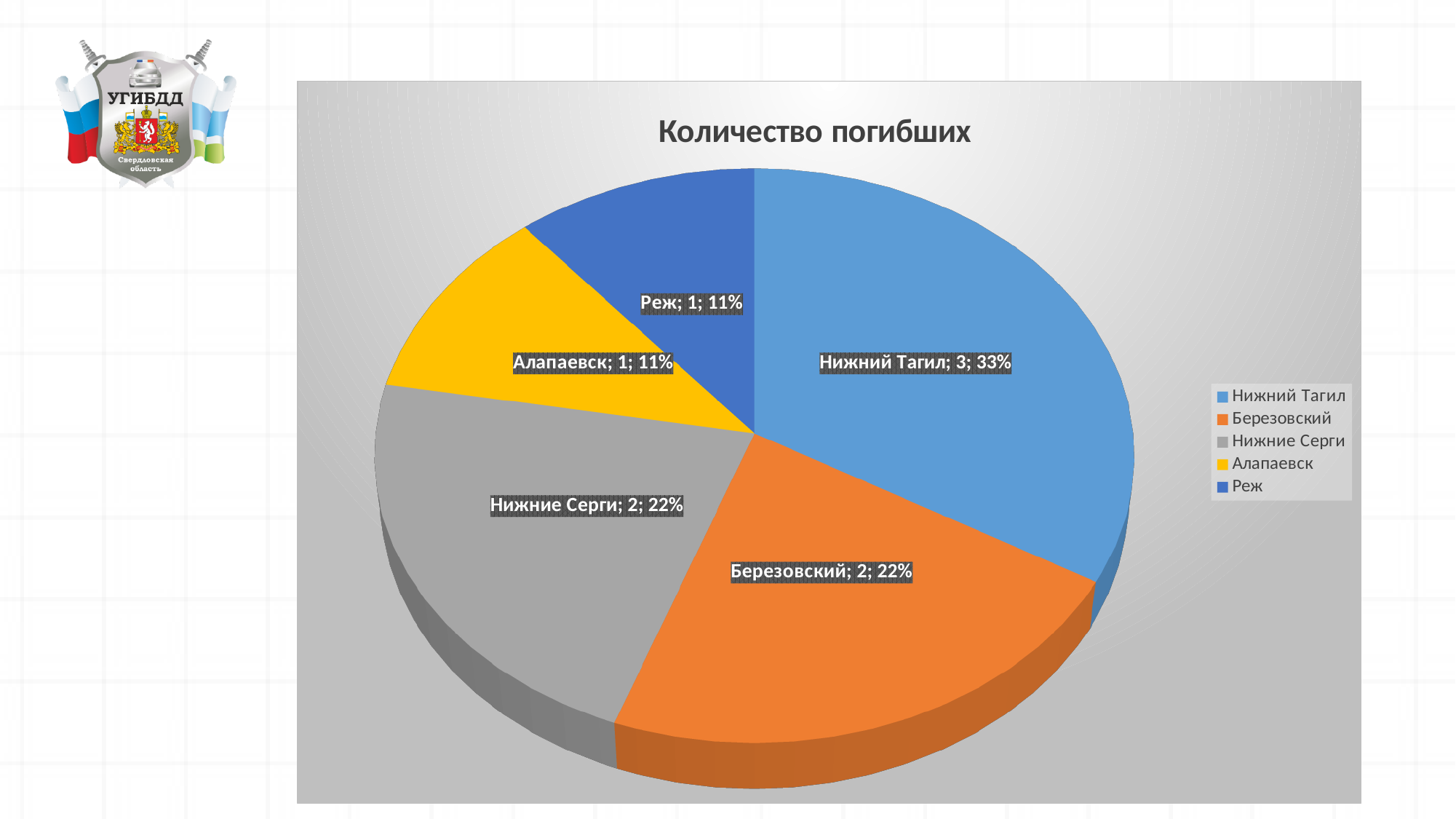
What is the title of the chart? Количество погибших What is the value for Реж? 1 What is the value for Нижний Тагил? 3 What is the value for Березовский? 2 What is the difference between the values for Нижний Тагил and Алапаевск? 2 How many categories does the pie chart have? 5 What colour is the slice for Алапаевск? yellow Which category has the highest value? Нижний Тагил Which is larger, the value for Березовский or the value for Реж? Березовский What kind of chart is shown on the slide? pie chart What share of the pie does Нижний Тагил represent? 33% What share of the pie does Нижние Серги represent? 22%